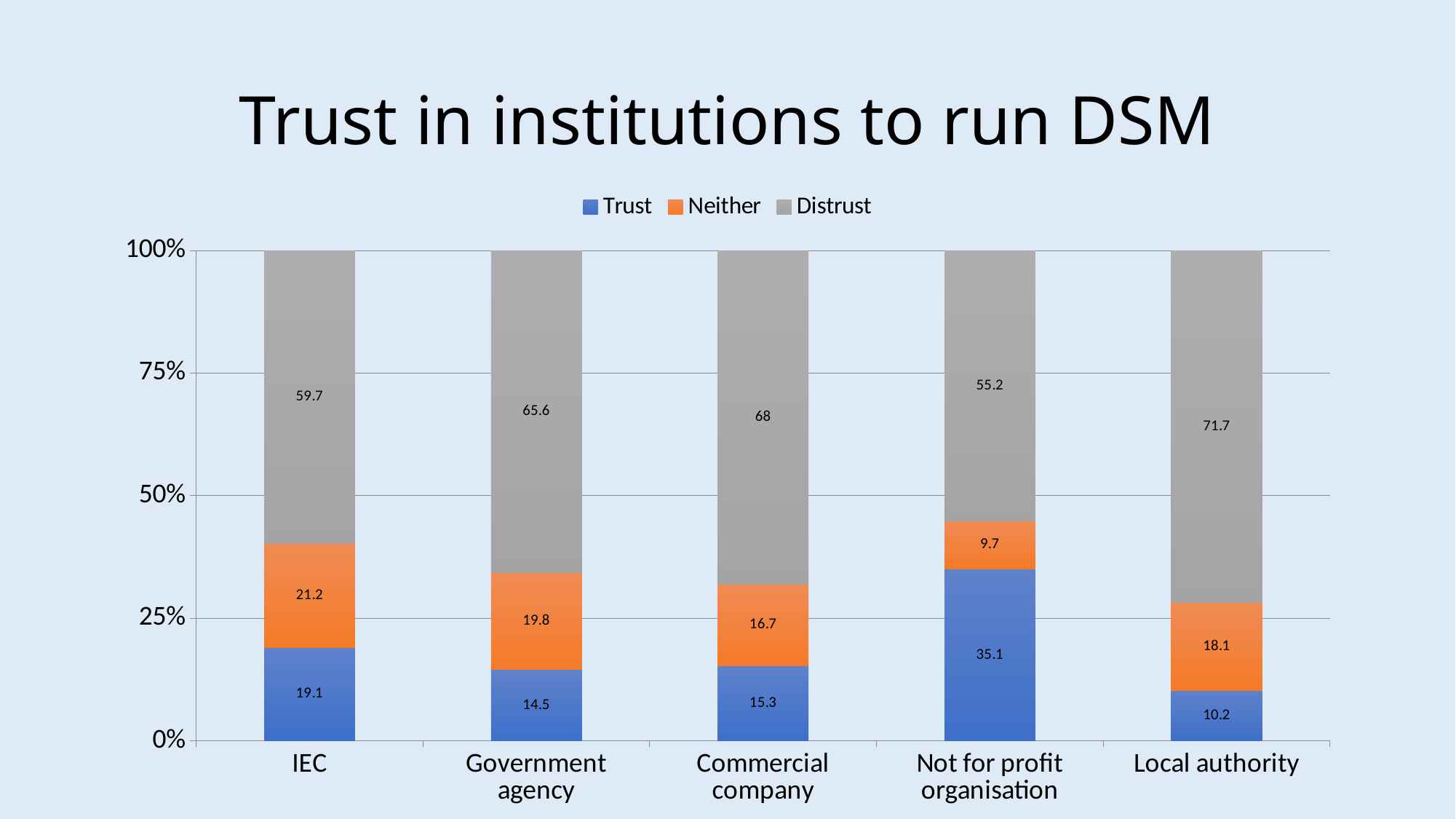
What is the Neither value for Government agency? 19.8 What is the Distrust value for Local authority? 71.7 What kind of chart is shown on the slide? Stacked bar chart What is the difference between the Distrust values for Local authority and IEC? 12 Which category has the lowest Distrust value? Not for profit organisation How many categories are shown on the x axis? 5 Which is larger, the Trust value for IEC or the Trust value for Commercial company? IEC Which category has the highest Trust value? Not for profit organisation What is the Distrust value for Commercial company? 68 What is the Trust value for Not for profit organisation? 35.1 Which category has the lowest Neither value? Not for profit organisation How many series does the legend list? 3